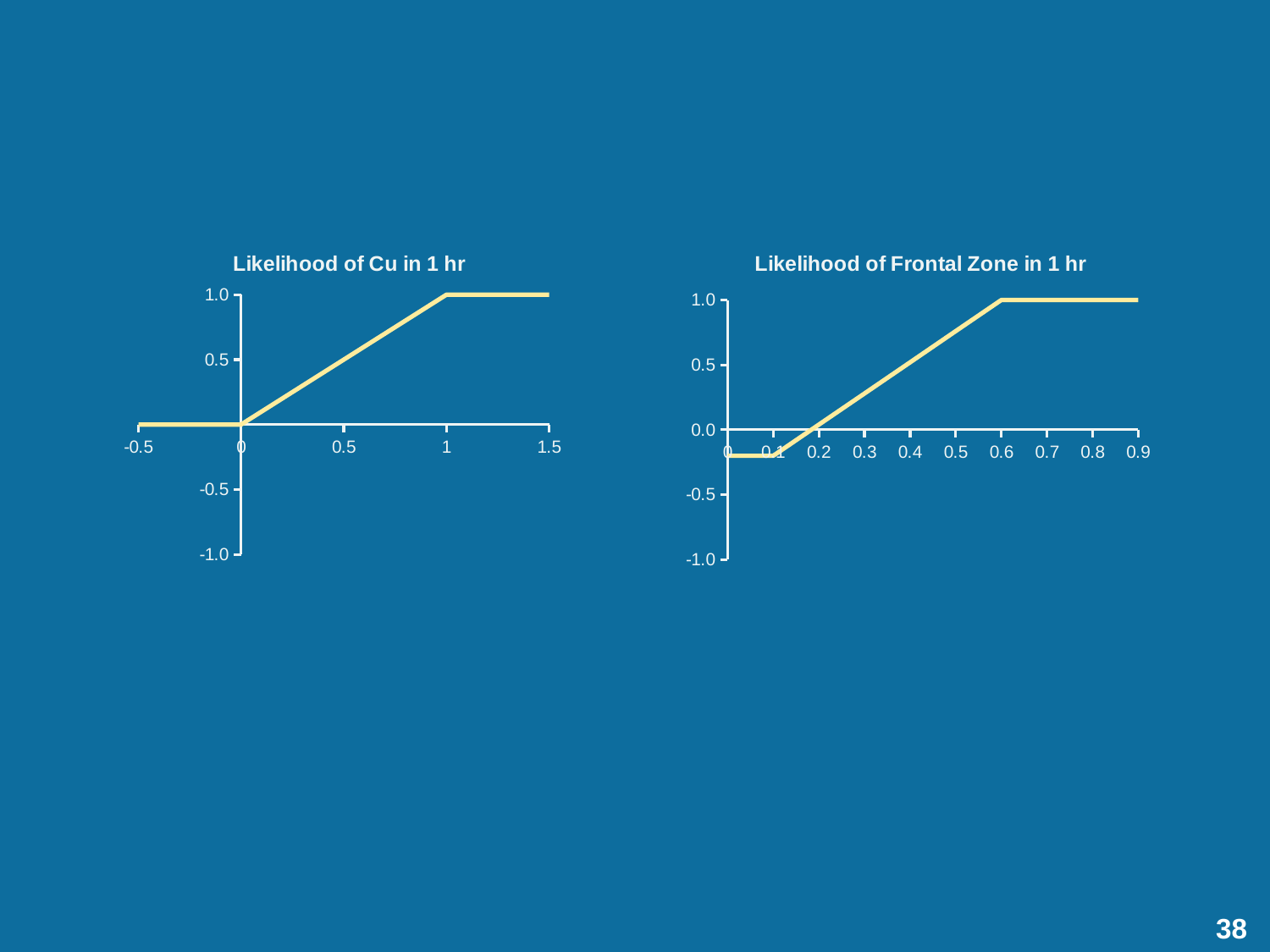
In "Likelihood of Cu in 1 hr", what is the value of the line at x = 1? 1.0 What is the title of the chart on the right side of the slide? Likelihood of Frontal Zone in 1 hr In "Likelihood of Cu in 1 hr", what is the value of the line at x = 1.5? 1.0 In "Likelihood of Frontal Zone in 1 hr", what is the value of the line at x = 0.6? 1.0 In "Likelihood of Frontal Zone in 1 hr", is the value of the line at x = 0.5 greater or less than 0.5? greater What type of chart is "Likelihood of Cu in 1 hr"? line chart What type of chart is "Likelihood of Frontal Zone in 1 hr"? line chart In "Likelihood of Cu in 1 hr", what is the value of the line at x = 0? 0 In "Likelihood of Frontal Zone in 1 hr", is the value of the line at x = 0.3 greater or less than 0.5? less In "Likelihood of Cu in 1 hr", does the line rise or fall between x = 0 and x = 1? rise In "Likelihood of Frontal Zone in 1 hr", what is the value of the line at x = 0.9? 1.0 In "Likelihood of Frontal Zone in 1 hr", is the value of the line at x = 0 greater or less than 0.0? less